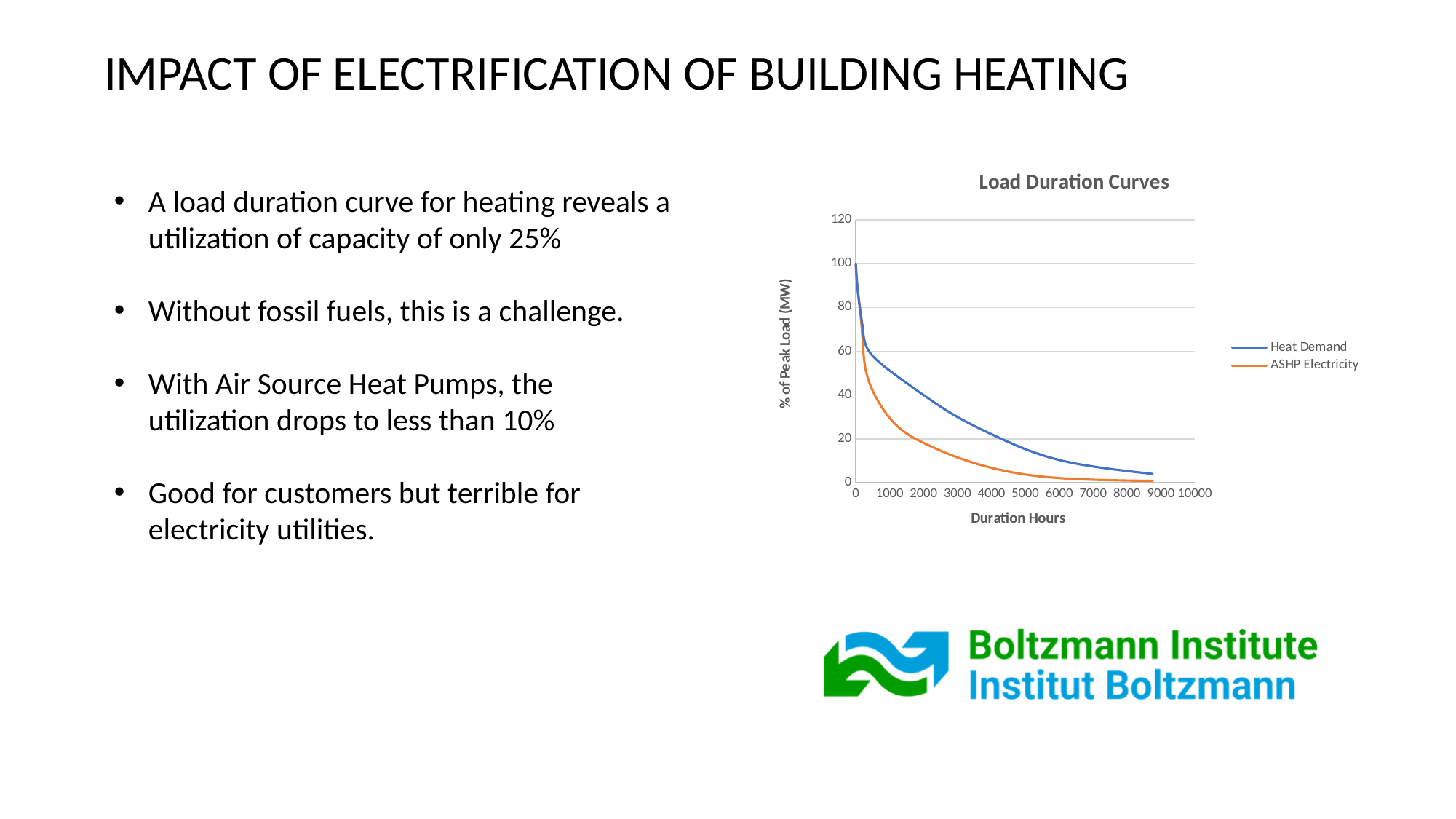
What kind of chart is shown on the slide? line chart Do the values of the ASHP Electricity series rise or fall along the x axis? fall Do the values of the Heat Demand series rise or fall as Duration Hours increase? fall Which series has the higher value at 2000 Duration Hours? Heat Demand Is the value of Heat Demand at 1000 Duration Hours greater or less than 40? greater What is the label of the y axis of the Load Duration Curves chart? % of Peak Load (MW) At 4000 Duration Hours, which series has the larger value, Heat Demand or ASHP Electricity? Heat Demand Is the value of ASHP Electricity at 6000 Duration Hours greater or less than 20? less How many series does the legend of the Load Duration Curves chart list? 2 Is the value of ASHP Electricity at 4000 Duration Hours greater or less than 20? less What is the title of the chart on the slide? Load Duration Curves